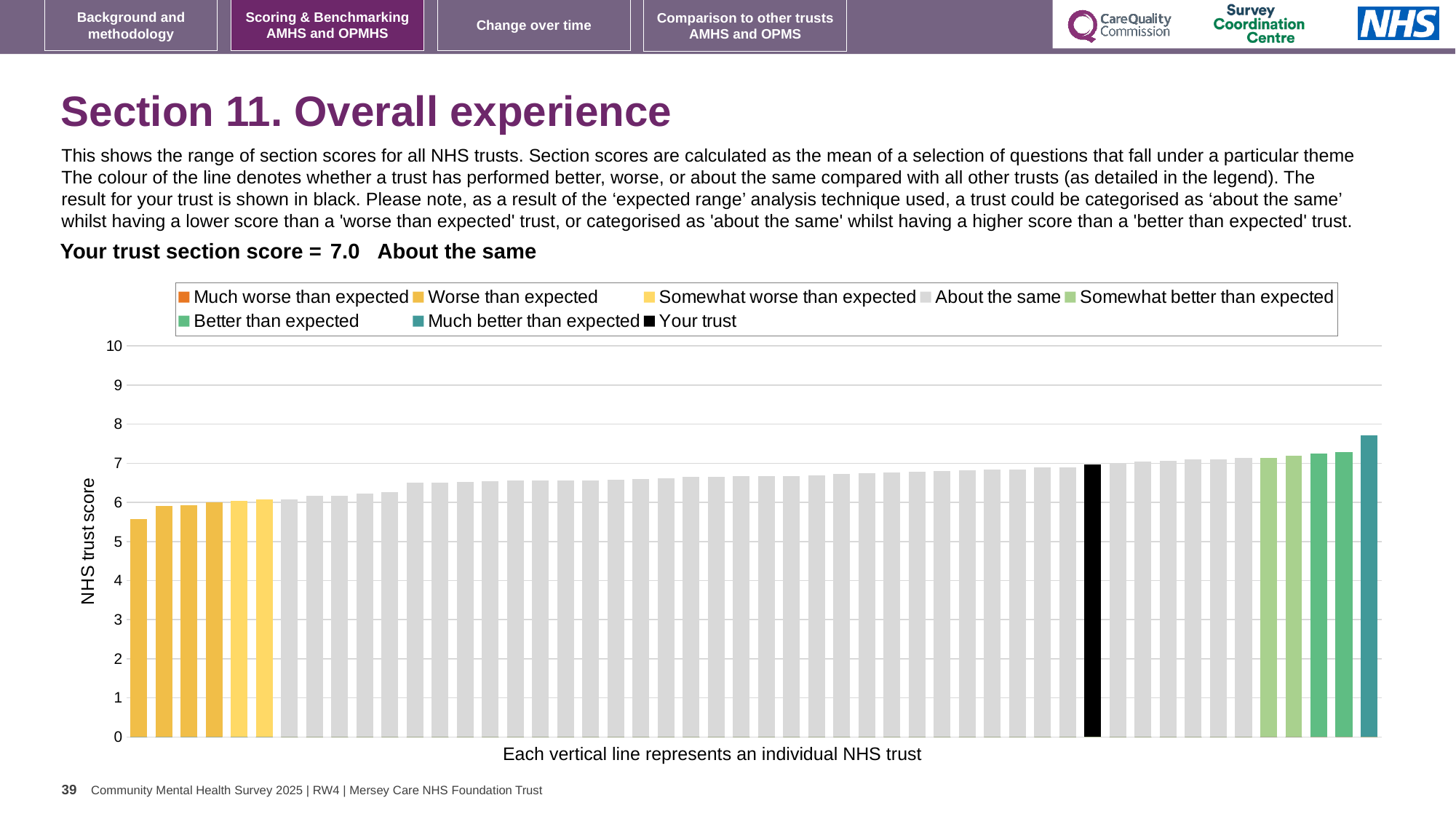
What kind of chart is shown on the slide? bar chart What colour is used for the 'Your trust' bar in the legend? black Is the value of the tallest bar (far right) greater or less than 7? greater Is the value of the shortest bar (far left) greater or less than 6? less What is the label on the vertical axis of the chart? NHS trust score Is the value of the tallest bar (far right) greater or less than 8? less Which legend category is your trust placed in for this section? About the same How many entries does the chart legend list? 8 Do the bar values rise or fall from left to right along the x axis? rise What is the section score for your trust shown on the slide? 7.0 Which legend category does the tallest bar belong to? Much better than expected